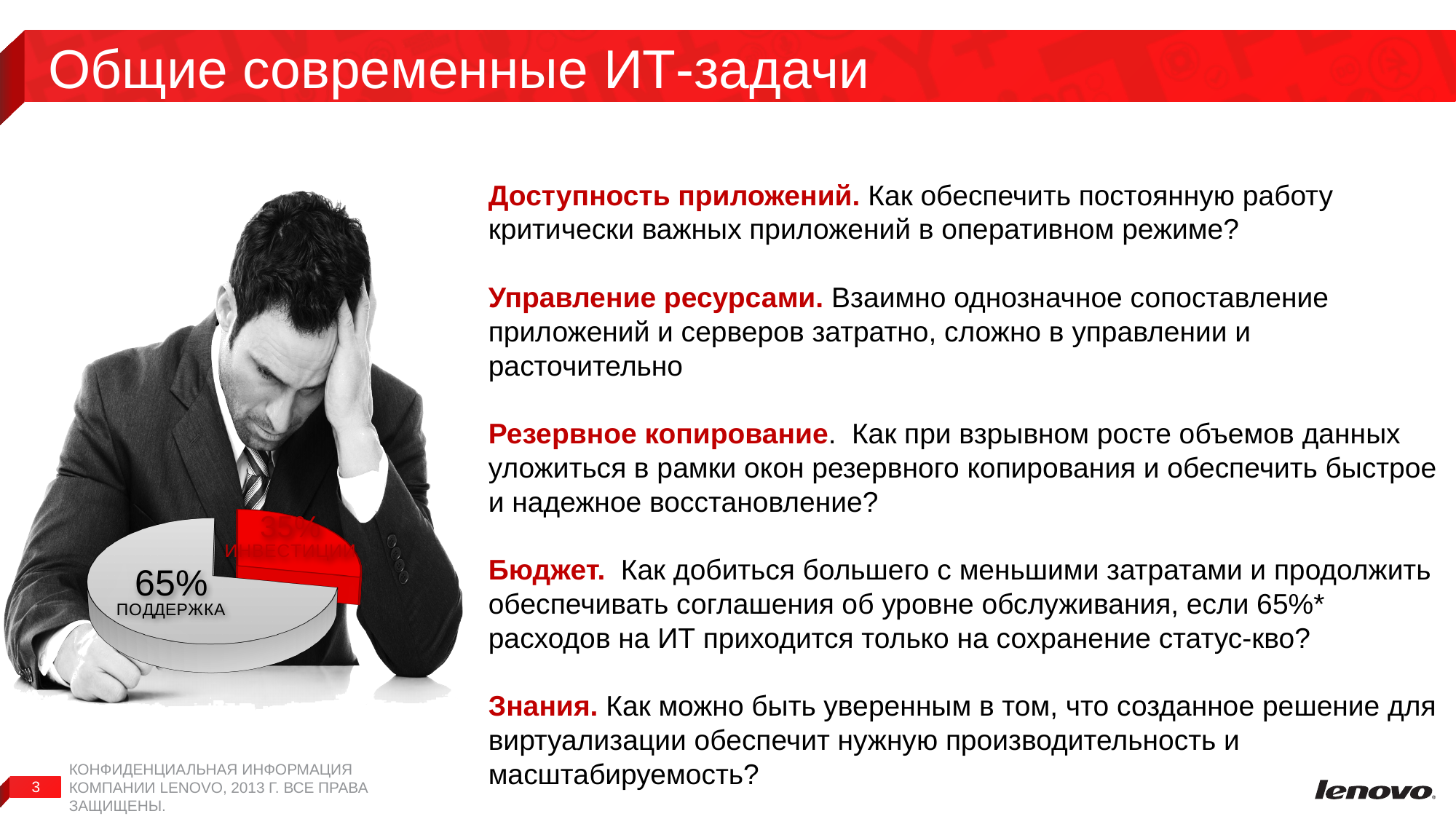
What share of the pie does the ПОДДЕРЖКА slice represent? 65% How many slices does the pie chart have? 2 What kind of chart is shown on the slide? pie chart Which slice of the pie chart is the largest? ПОДДЕРЖКА What colour is the ПОДДЕРЖКА slice in the pie chart? grey Which slice of the pie chart is the smallest? ИНВЕСТИЦИИ What colour is the ИНВЕСТИЦИИ slice in the pie chart? red Which is larger in the pie chart, ПОДДЕРЖКА or ИНВЕСТИЦИИ? ПОДДЕРЖКА What is the value of the ИНВЕСТИЦИИ slice in the pie chart? 35% What is the value of the ПОДДЕРЖКА slice in the pie chart? 65% What is the difference between the ПОДДЕРЖКА and ИНВЕСТИЦИИ slices in the pie chart? 30%